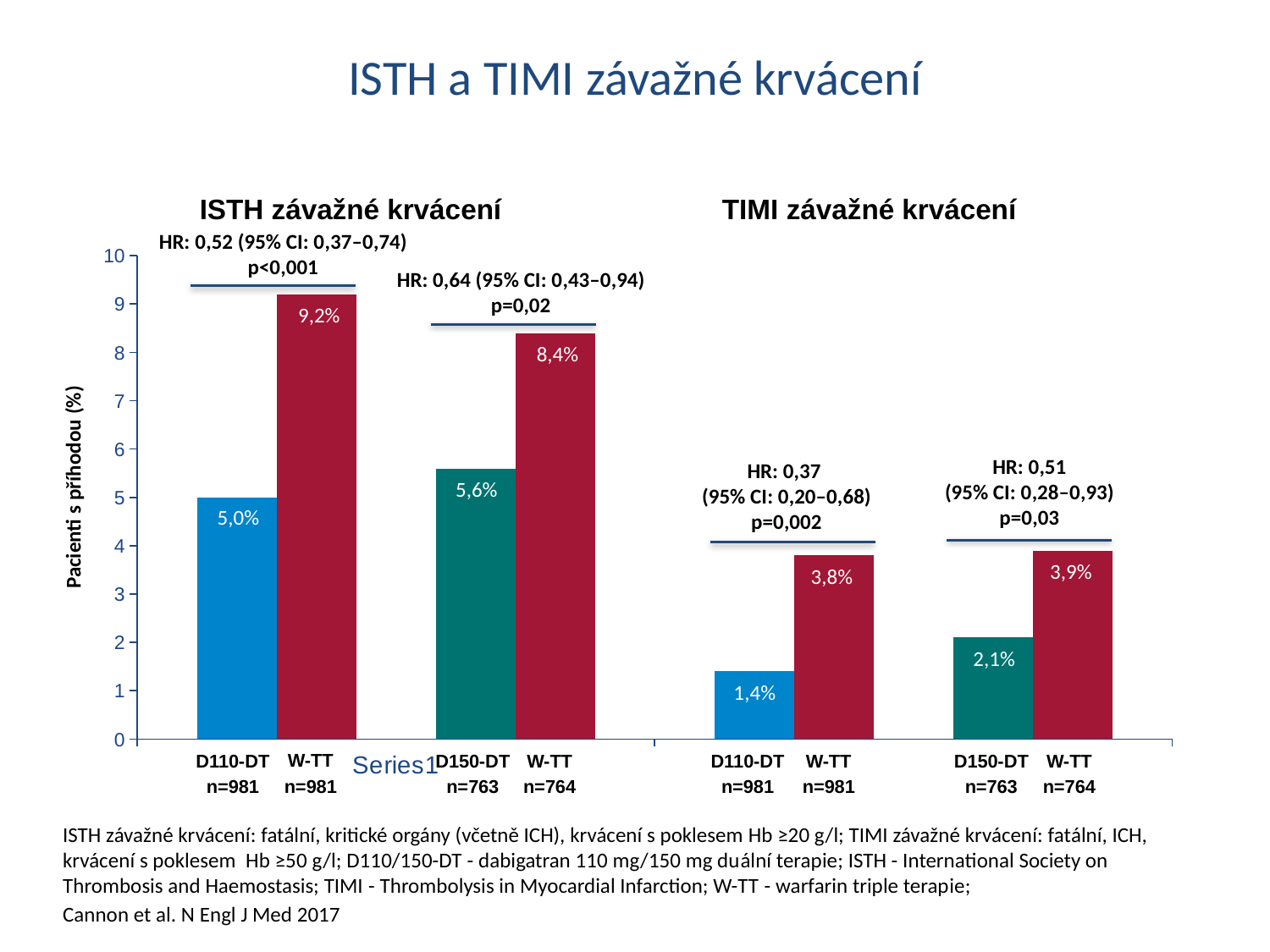
Is the value for D150-DT in the ISTH section greater or less than 5? greater In the ISTH section, what is the difference between W-TT (9,2%) and D110-DT (5,0%)? 4,2 percentage points In the ISTH závažné krvácení section, what is the value for W-TT next to D110-DT? 9,2% How many bars are plotted on the chart in total? 8 In the ISTH závažné krvácení section, what is the value for D110-DT? 5,0% In the TIMI závažné krvácení section, what is the value for W-TT next to D110-DT? 3,8% Which bar has the lowest value on the whole chart? D110-DT (TIMI), 1,4% In the ISTH section, which is larger: D150-DT or D110-DT? D150-DT In the TIMI section, what is the difference between W-TT (3,9%) and D150-DT (2,1%)? 1,8 percentage points What kind of chart is shown on the slide? Bar chart Which bar has the highest value on the whole chart? W-TT (ISTH, next to D110-DT), 9,2% In the TIMI závažné krvácení section, what is the value for D150-DT? 2,1%